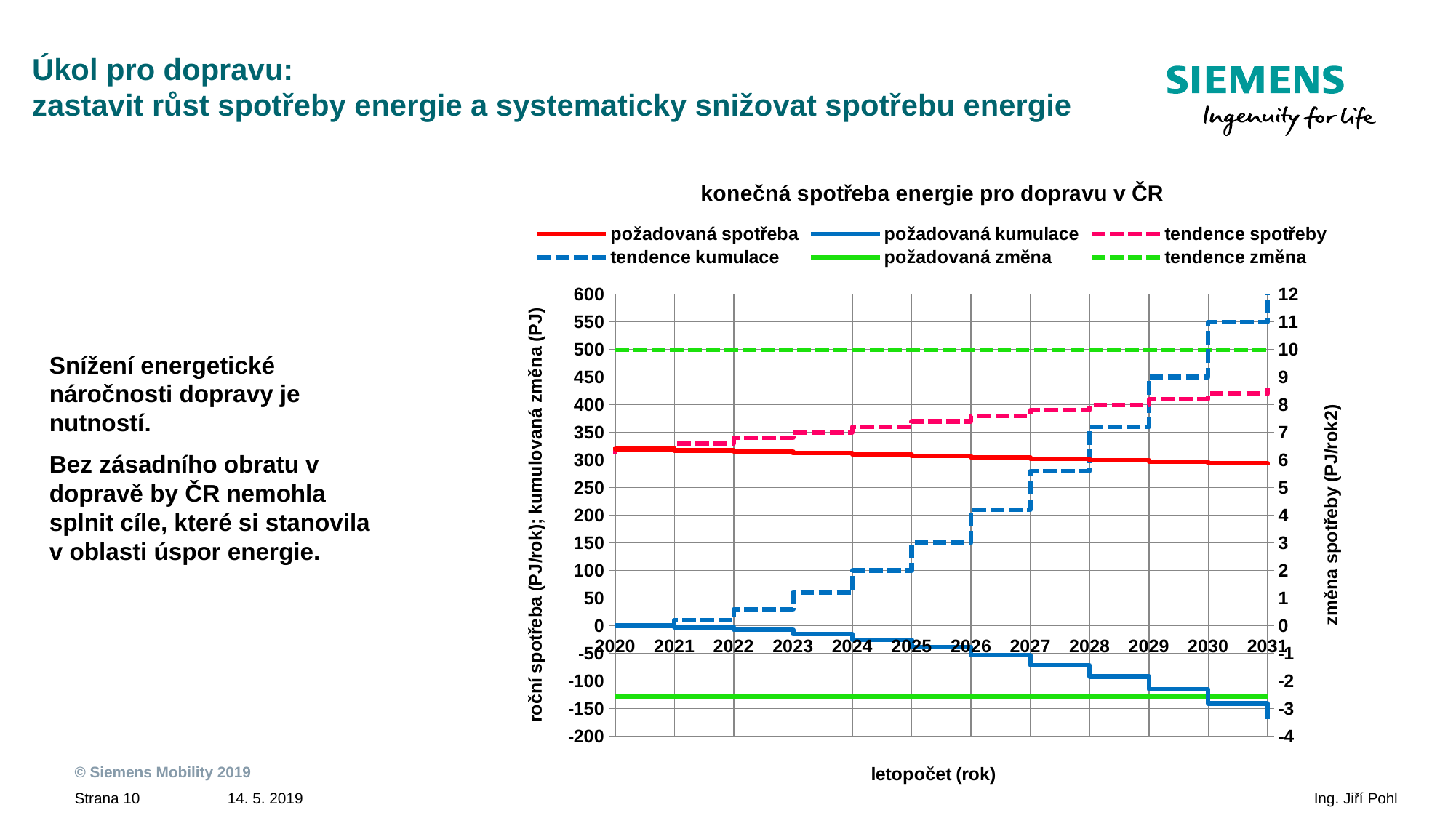
What is the label of the x axis of the chart? letopočet (rok) How many years are labelled on the x axis of the chart? 12 Does the 'požadovaná kumulace' series rise or fall from 2020 to 2031? fall In 2031, which is larger: 'tendence spotřeby' or 'požadovaná spotřeba'? tendence spotřeby What kind of chart is shown on the slide? line chart Is the value of 'požadovaná kumulace' in 2031 greater or less than -100? less Is the value of 'požadovaná spotřeba' in 2031 greater or less than 350? less Does the 'tendence kumulace' series rise or fall from 2020 to 2031? rise Does the 'tendence spotřeby' series rise or fall from 2020 to 2031? rise What is the title of the chart? konečná spotřeba energie pro dopravu v ČR How many series does the legend of the chart list? 6